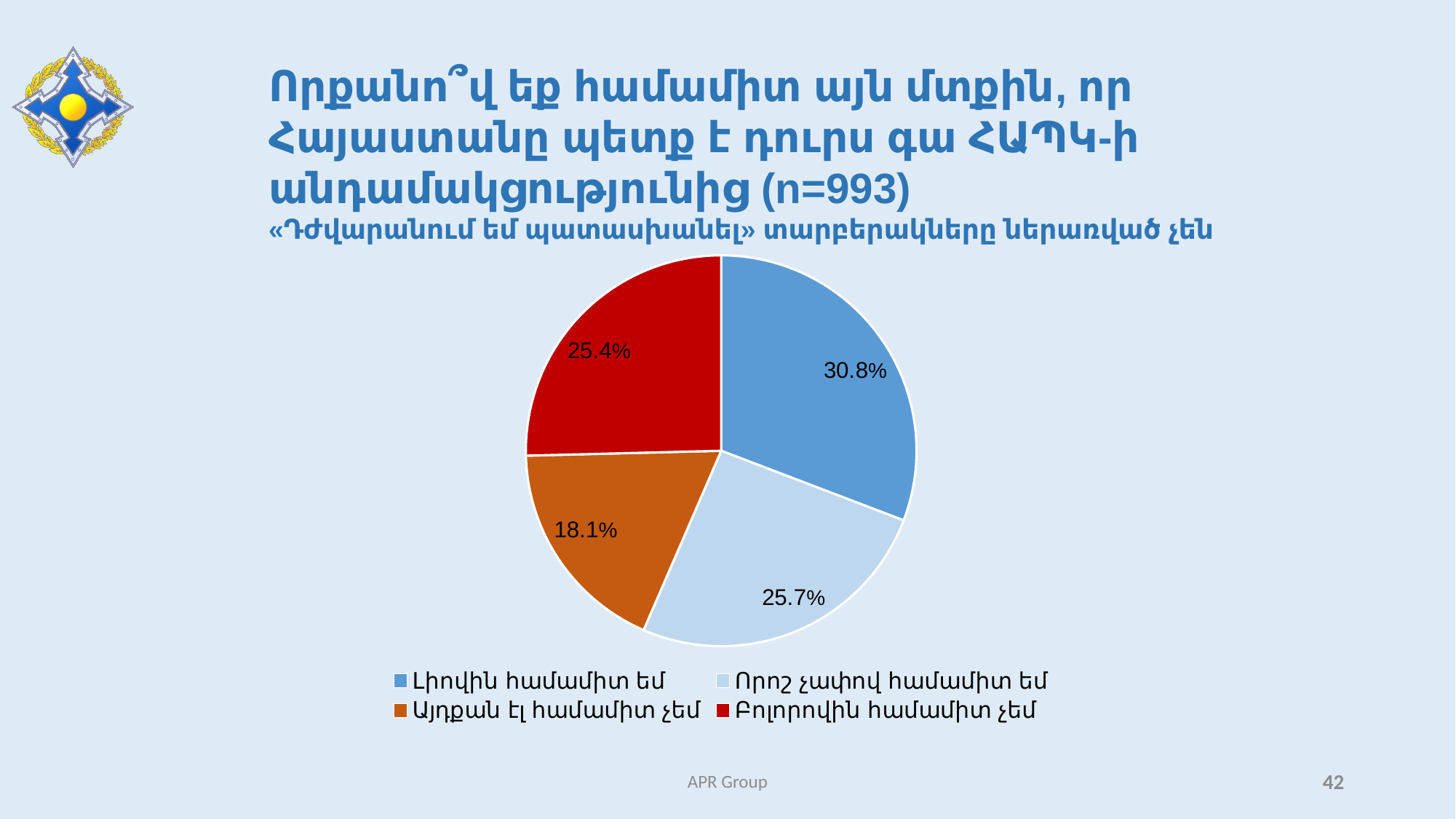
How many slices does the pie chart have? 4 Which is larger: the share for "Լիովին համամիտ եմ" or the share for "Բոլորովին համամիտ չեմ"? Լիովին համամիտ եմ What percentage of respondents answered "Լիովին համամիտ եմ"? 30.8% What type of chart is shown on the slide? Pie chart What percentage of respondents answered "Որոշ չափով համամիտ եմ"? 25.7% What colour is the slice for "Բոլորովին համամիտ չեմ"? Red What percentage of respondents answered "Այդքան էլ համամիտ չեմ"? 18.1% Which response category has the largest share of the pie? Լիովին համամիտ եմ What is the difference in percentage points between "Լիովին համամիտ եմ" and "Այդքան էլ համամիտ չեմ"? 12.7 What is the sample size (n) stated in the chart title? 993 Which response category has the smallest share of the pie? Այդքան էլ համամիտ չեմ What percentage of respondents answered "Բոլորովին համամիտ չեմ"? 25.4%